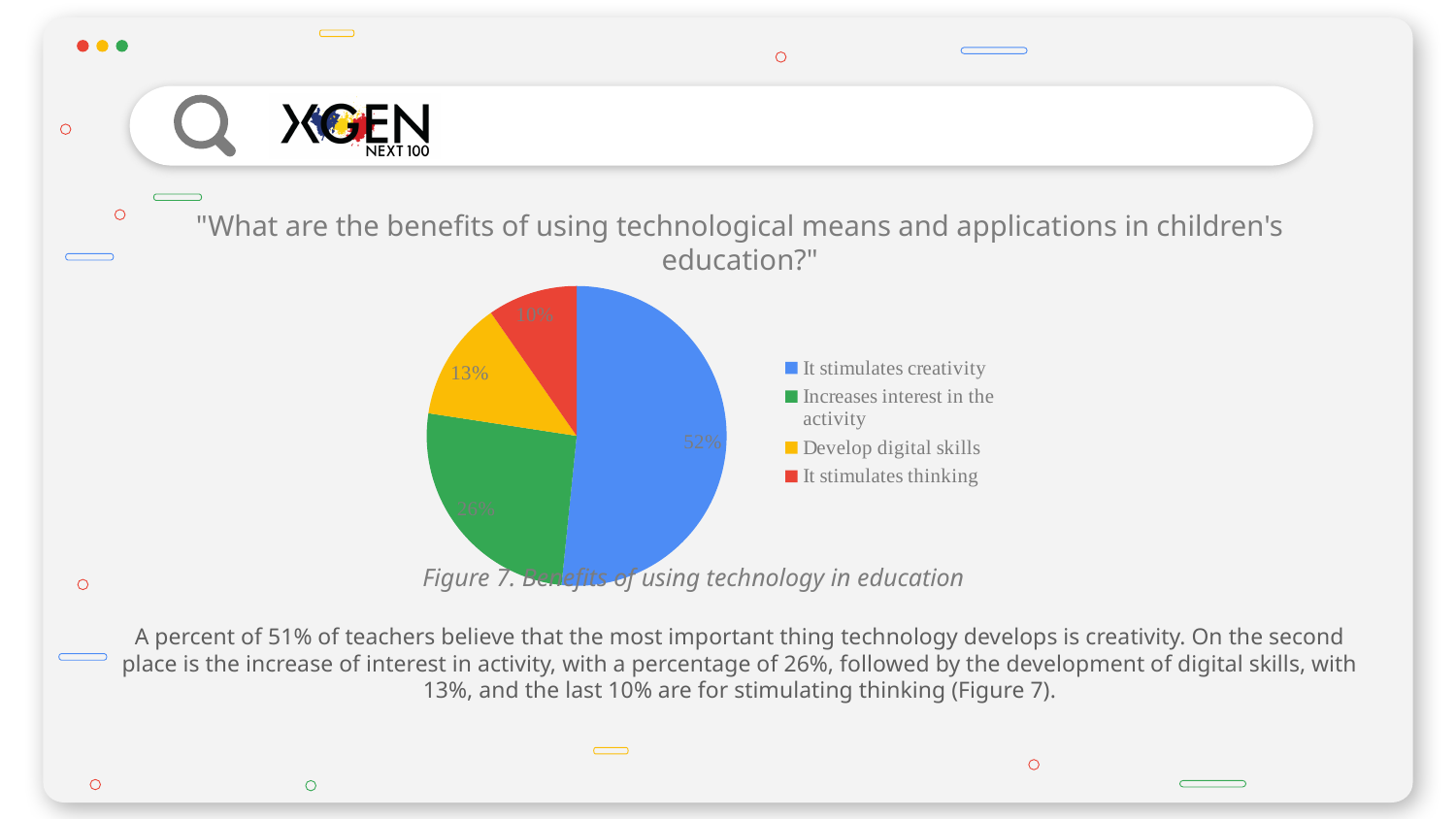
What type of chart is shown on the slide? pie chart What colour is the slice for "It stimulates thinking"? red Which is larger, the slice for "Develop digital skills" or the slice for "Increases interest in the activity"? Increases interest in the activity What percentage of the pie is labelled for "It stimulates creativity"? 52% What is the difference in percentage points between "Increases interest in the activity" and "Develop digital skills"? 13 What percentage is shown for "Increases interest in the activity"? 26% What percentage is shown for "It stimulates thinking"? 10% What percentage is shown for "Develop digital skills"? 13% How many categories does the legend list? 4 Which category has the smallest slice of the pie? It stimulates thinking Which category has the largest slice of the pie? It stimulates creativity What is the figure caption below the chart? Figure 7. Benefits of using technology in education